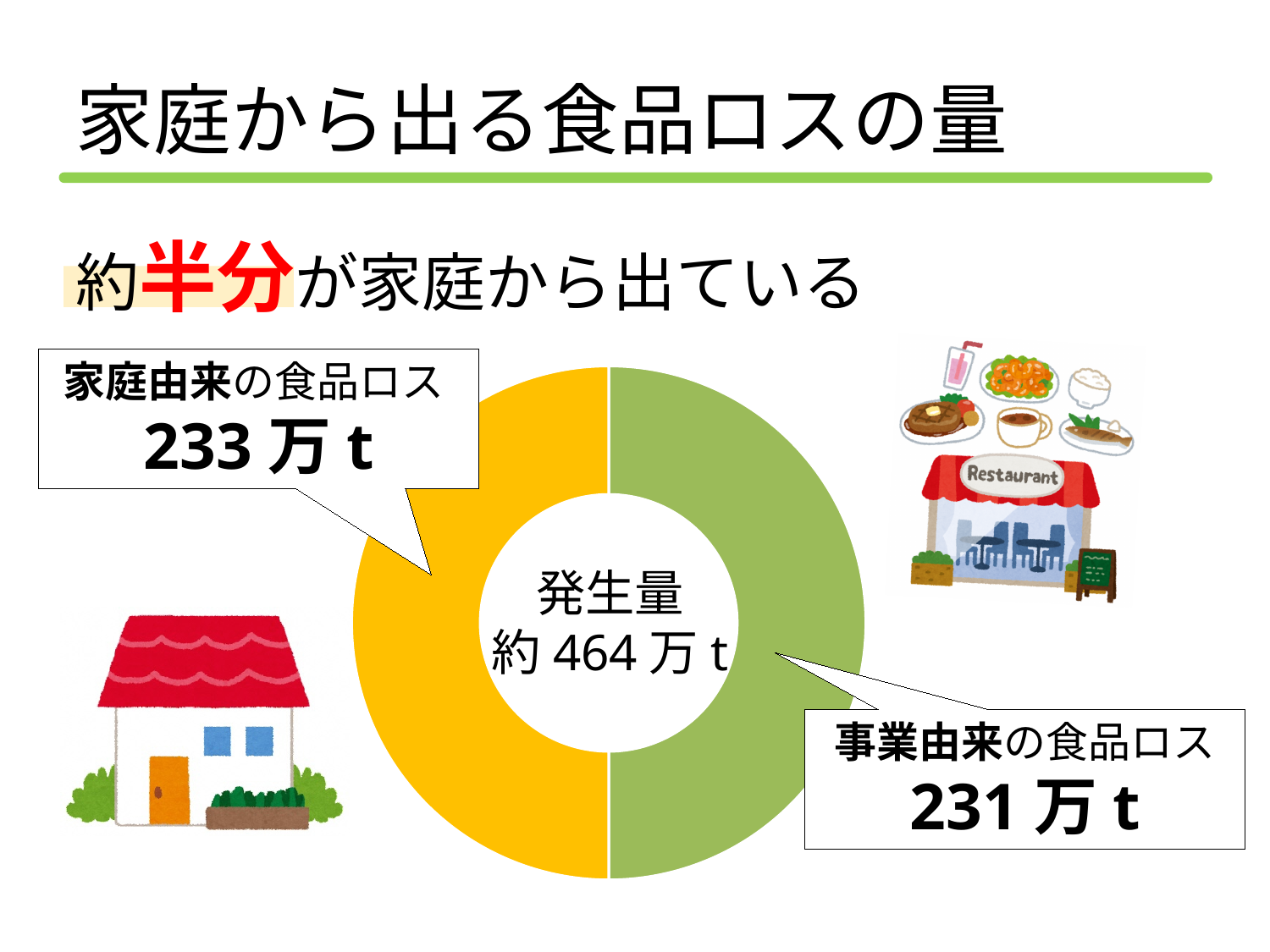
What colour is the 家庭由来の食品ロス segment in the donut chart? yellow Which segment is larger according to the labels, 家庭由来の食品ロス or 事業由来の食品ロス? 家庭由来の食品ロス What is the value for 事業由来の食品ロス in the donut chart? 231万t What kind of chart is shown on the slide? donut chart What is the difference between 家庭由来の食品ロス and 事業由来の食品ロス? 2万t How many segments does the donut chart have? 2 What is the title of the slide containing the donut chart? 家庭から出る食品ロスの量 Which segment has the highest value in the donut chart? 家庭由来の食品ロス What is the value for 家庭由来の食品ロス in the donut chart? 233万t What is the sum of the two segments of the donut chart? 464万t What total 発生量 is shown in the centre of the donut chart? 約464万t Which segment has the lowest value in the donut chart? 事業由来の食品ロス